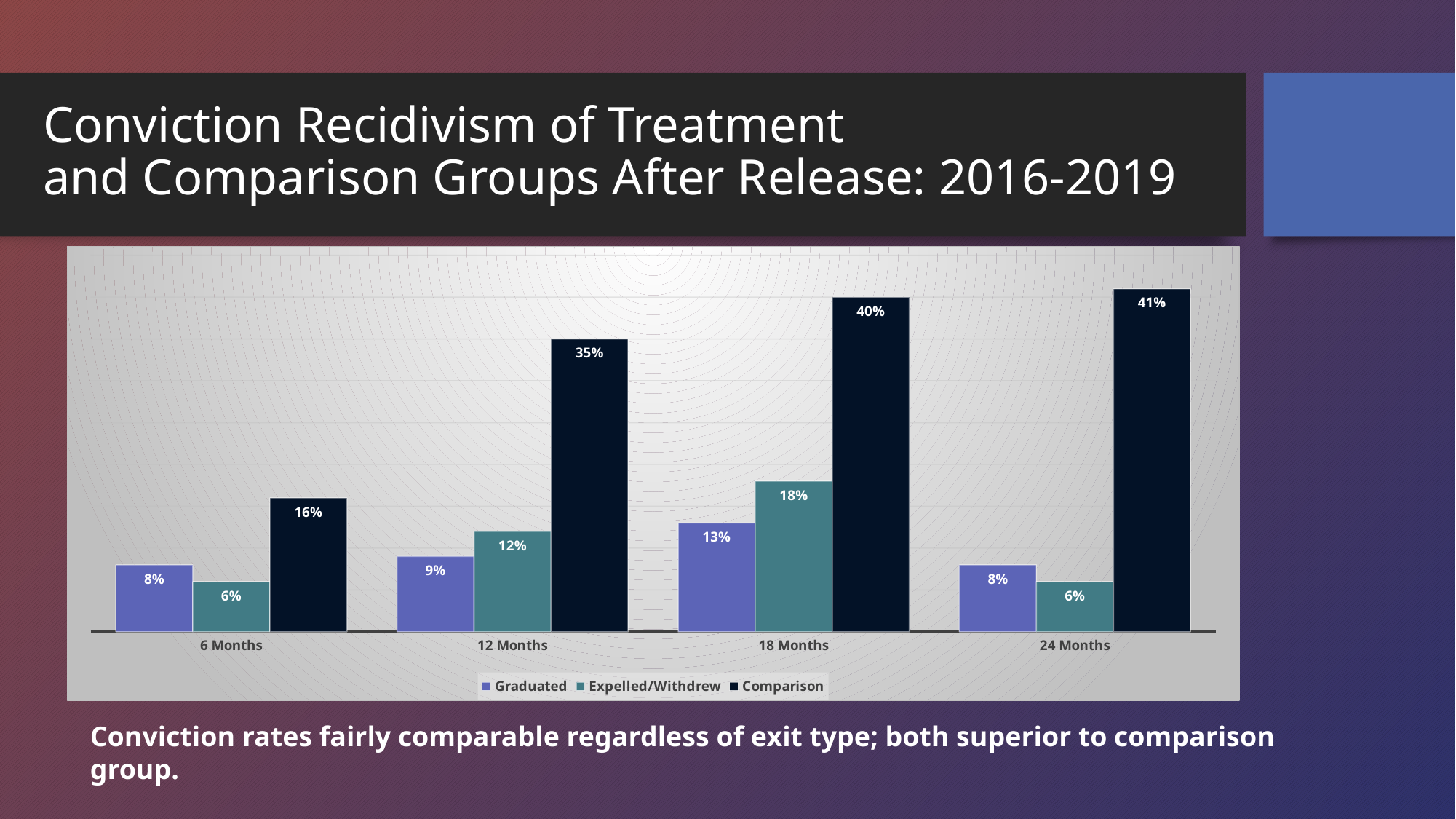
What is the value for the Expelled/Withdrew group at 12 Months? 12% Do the Comparison group's values rise or fall from 6 Months to 24 Months? Rise Which series is shown in the darkest (navy/black) colour in the legend? Comparison Which group has the lowest value at 6 Months? Expelled/Withdrew How many series does the legend list? 3 What is the value for the Graduated group at 24 Months? 8% What is the conviction recidivism rate for the Comparison group at 18 Months? 40% What kind of chart is shown on the slide? Bar chart At 18 Months, which is larger: the Graduated value or the Expelled/Withdrew value? Expelled/Withdrew At which time point is the Comparison group's value highest? 24 Months What is the difference between the Comparison and Graduated values at 12 Months? 26% How many time-point categories are shown on the x axis? 4